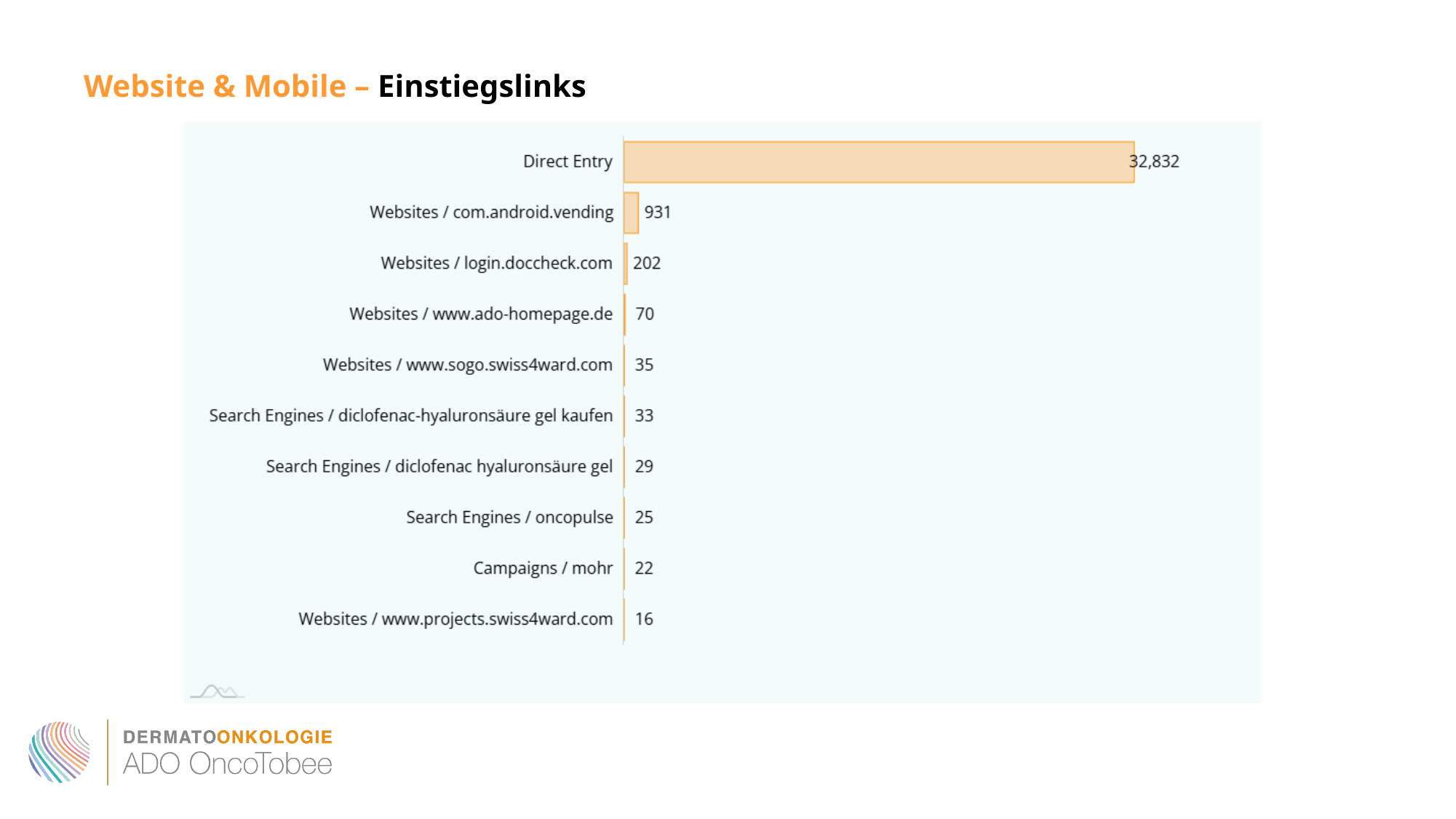
Which is larger, the value for Search Engines / oncopulse or the value for Campaigns / mohr? Search Engines / oncopulse What is the difference between the values for Websites / www.ado-homepage.de and Websites / www.sogo.swiss4ward.com? 35 Which category has the lowest value? Websites / www.projects.swiss4ward.com What is the value for Campaigns / mohr? 22 What is the title of the slide? Website & Mobile – Einstiegslinks What is the value for Websites / com.android.vending? 931 What is the value for Websites / login.doccheck.com? 202 What is the value for Direct Entry? 32,832 What is the difference between the values for Websites / com.android.vending and Websites / login.doccheck.com? 729 How many categories are shown in the chart? 10 What kind of chart is shown on the slide? Bar chart Which category has the highest value? Direct Entry